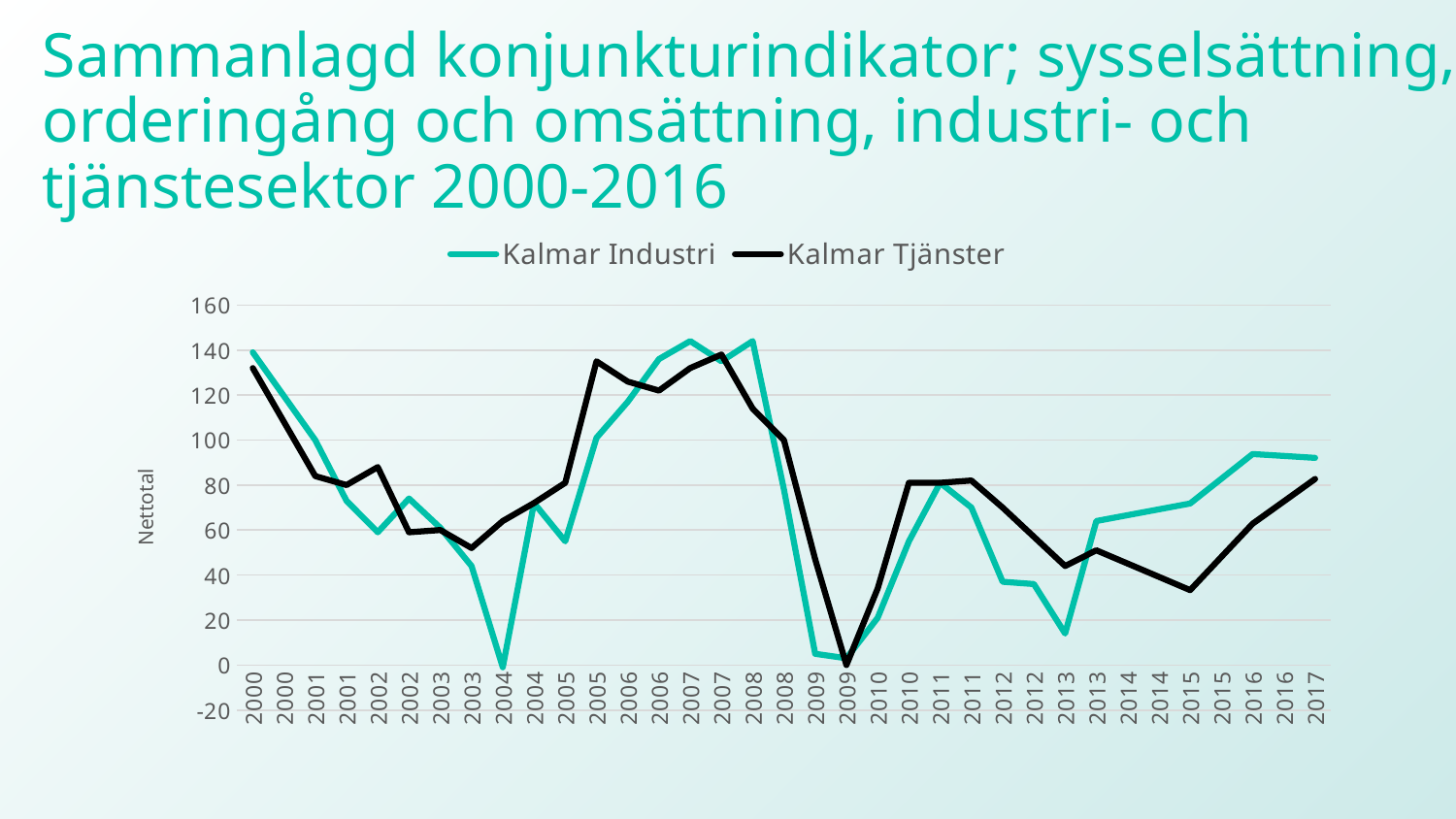
At the first 2016 point, which series has the larger value, Kalmar Industri or Kalmar Tjänster? Kalmar Industri Is the value for Kalmar Industri at the first 2007 point greater or less than 140? greater Is the value for Kalmar Tjänster at the first 2015 point greater or less than 40? less Which series is drawn with the black line? Kalmar Tjänster How many series does the legend list? 2 At which x-axis point does Kalmar Tjänster reach its lowest value? 2009 (second point) Is the value for Kalmar Tjänster at the second 2005 point greater or less than 120? greater Does the Kalmar Industri line rise or fall from 2013 to 2016? rise At the first 2004 point, which series has the larger value, Kalmar Industri or Kalmar Tjänster? Kalmar Tjänster What kind of chart is shown on the slide? Line chart What is the label on the vertical axis? Nettotal